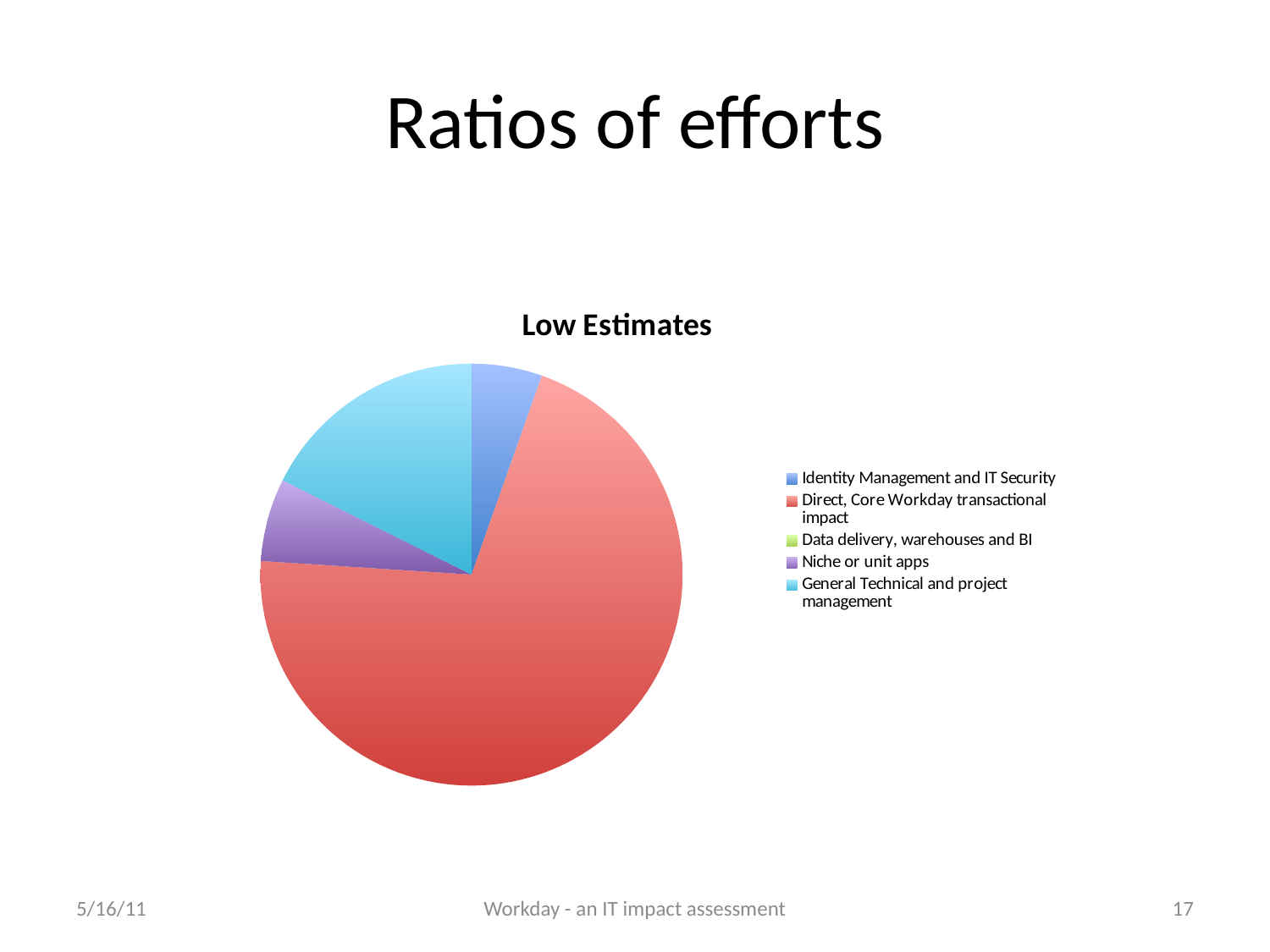
What is the title of the chart? Low Estimates Which category has the second-largest slice of the pie? General Technical and project management Which is larger: the slice for Direct, Core Workday transactional impact or the slice for General Technical and project management? Direct, Core Workday transactional impact Which category has the largest slice of the pie? Direct, Core Workday transactional impact Which is larger: the slice for General Technical and project management or the slice for Identity Management and IT Security? General Technical and project management Does the slice for Direct, Core Workday transactional impact take up more or less than half of the pie? more What colour is the slice for Direct, Core Workday transactional impact? red How many entries does the chart's legend list? 5 What kind of chart is shown on the slide? pie chart